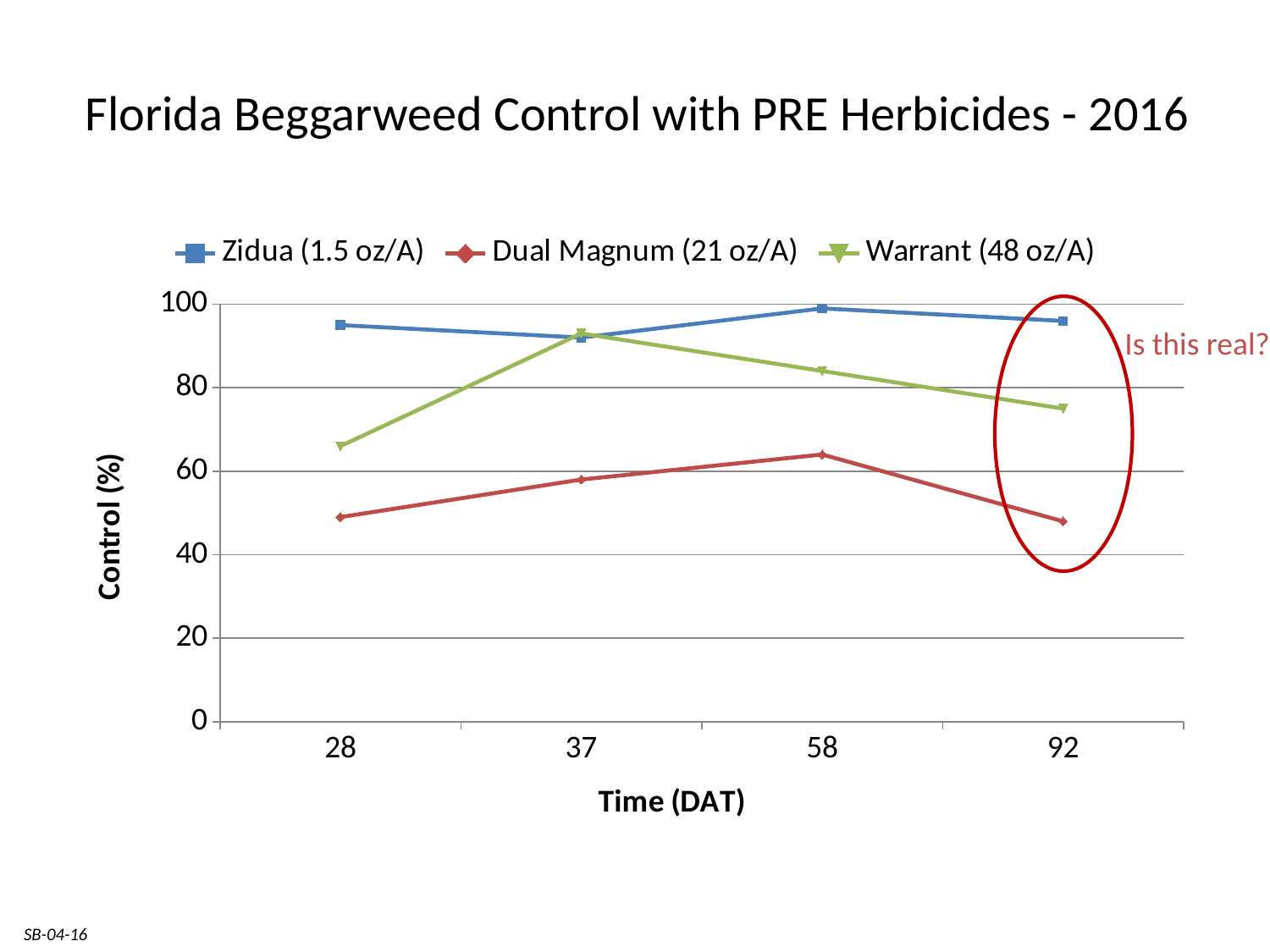
Which herbicide has the highest control at 92 DAT? Zidua (1.5 oz/A) At 37 DAT, which has higher control: Warrant (48 oz/A) or Dual Magnum (21 oz/A)? Warrant (48 oz/A) Is the control value for Zidua (1.5 oz/A) at 58 DAT greater or less than 80? greater Is the control value for Warrant (48 oz/A) at 92 DAT greater or less than 80? less Does the control for Dual Magnum (21 oz/A) rise or fall from 28 DAT to 58 DAT? Rise Does the control for Warrant (48 oz/A) rise or fall from 37 DAT to 92 DAT? Fall What kind of chart is shown on the slide? Line chart How many time points (DAT) are plotted on the x axis? 4 How many series does the legend list? 3 What is the label of the y axis? Control (%) Is the control value for Dual Magnum (21 oz/A) at 28 DAT greater or less than 60? less Which herbicide has the lowest control at 28 DAT? Dual Magnum (21 oz/A)